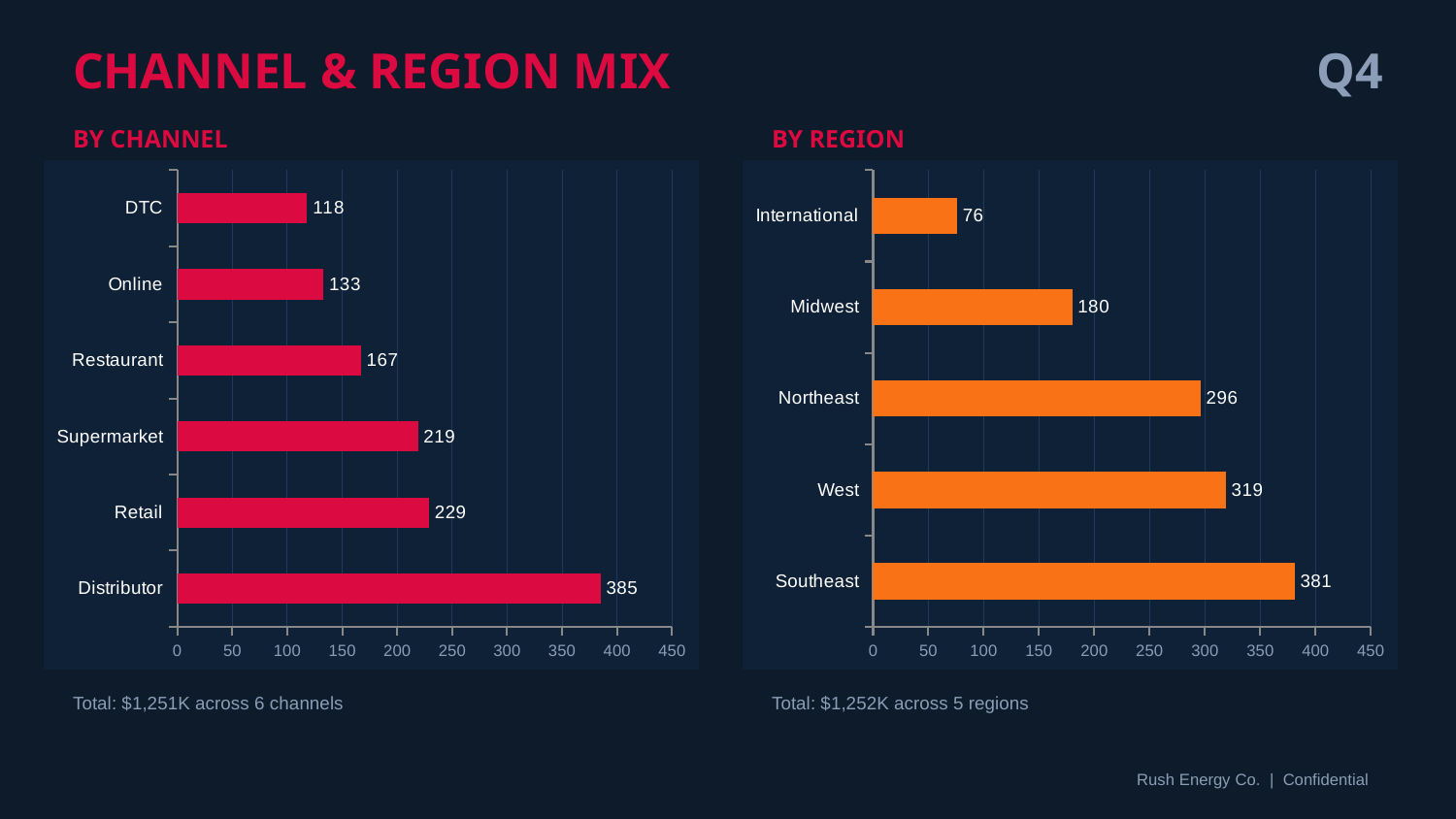
In the BY REGION chart, what is the value for Midwest? 180 What type of chart is the BY REGION chart? Bar chart In the BY REGION chart, is the value for Northeast greater or less than 250? greater How many channels are shown in the BY CHANNEL chart? 6 How many regions are shown in the BY REGION chart? 5 In the BY CHANNEL chart, what is the value for Restaurant? 167 In the BY CHANNEL chart, what is the difference between Retail and Supermarket? 10 What colour are the bars in the BY CHANNEL chart? Red In the BY CHANNEL chart, which channel has the highest value? Distributor In the BY REGION chart, which region has the lowest value? International In the BY CHANNEL chart, which is larger, Online or DTC? Online In the BY REGION chart, what is the difference between Southeast and West? 62